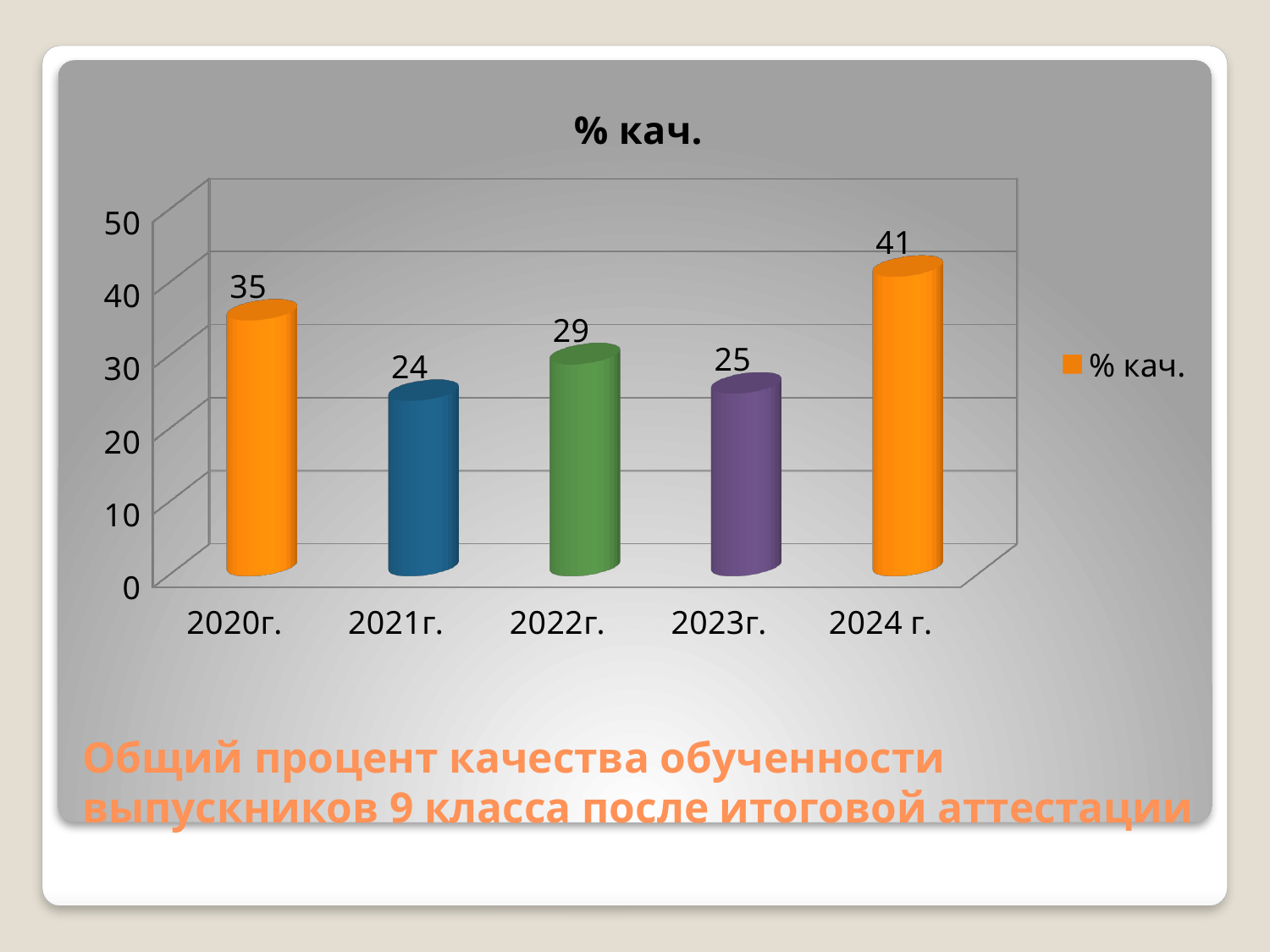
Which year has the lowest value? 2021г. What is the title of the chart? % кач. What is the value for 2024 г.? 41 Which is larger, the value for 2020г. or the value for 2022г.? 2020г. What is the value for 2020г.? 35 What is the difference between the values for 2024 г. and 2021г.? 17 What kind of chart is shown? bar chart What is the value for 2023г.? 25 How many years are shown on the x axis? 5 How many series does the legend list? 1 Is the value for 2022г. greater or less than 30? less Which year has the highest value? 2024 г.